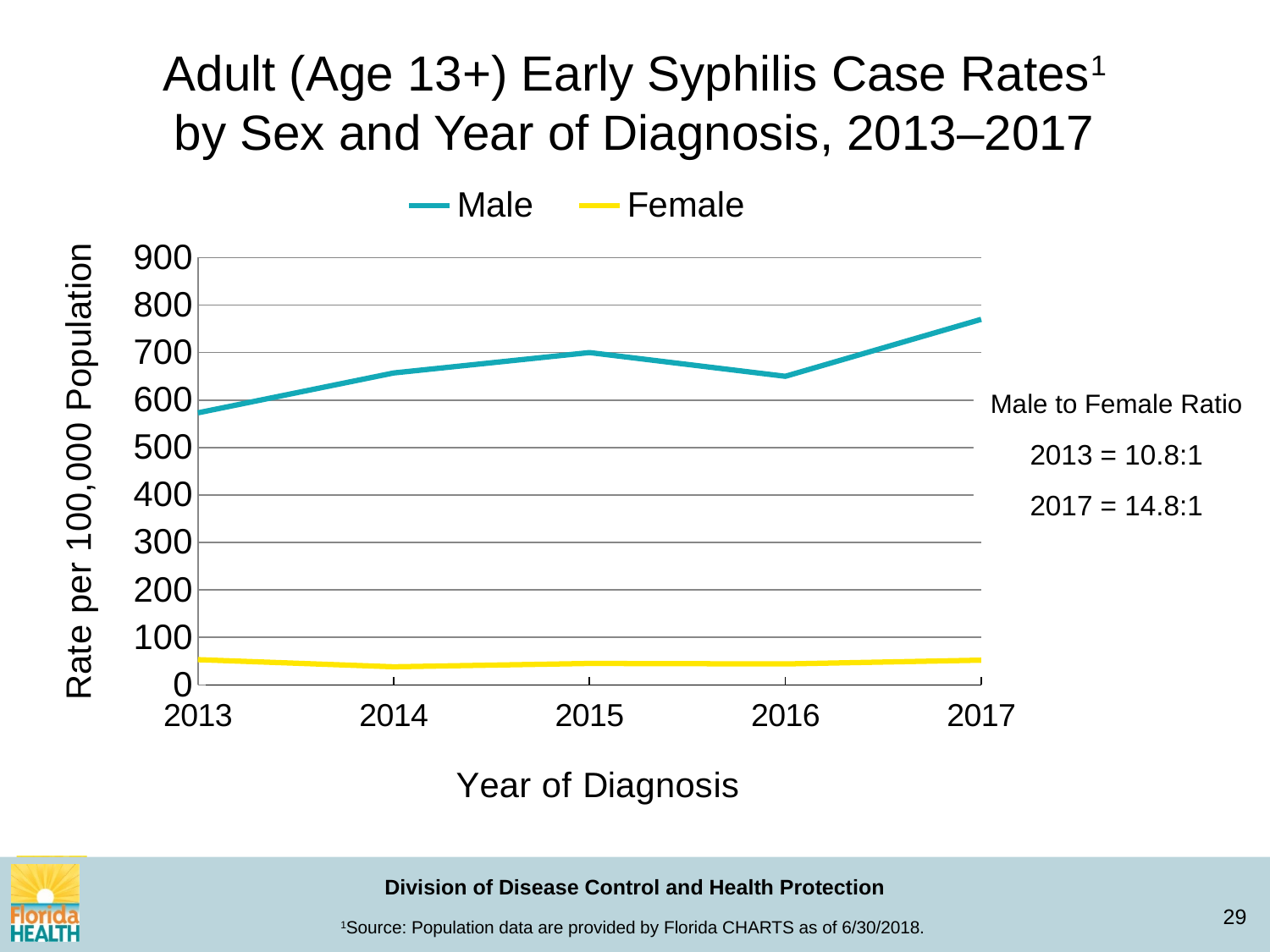
Is the Female rate in 2015 greater or less than 100? less How many series does the legend list? 2 In which year is the Male rate lowest? 2013 Does the Male rate rise or fall from 2016 to 2017? rise According to the text beside the chart, what was the male to female ratio in 2017? 14.8:1 Is the Male rate in 2016 greater or less than 700? less In which year is the Male rate highest? 2017 How many years are plotted along the x axis? 5 Is the Male rate in 2017 greater or less than 700? greater Which series has the higher rate in 2014, Male or Female? Male What kind of chart is shown on the slide? line chart